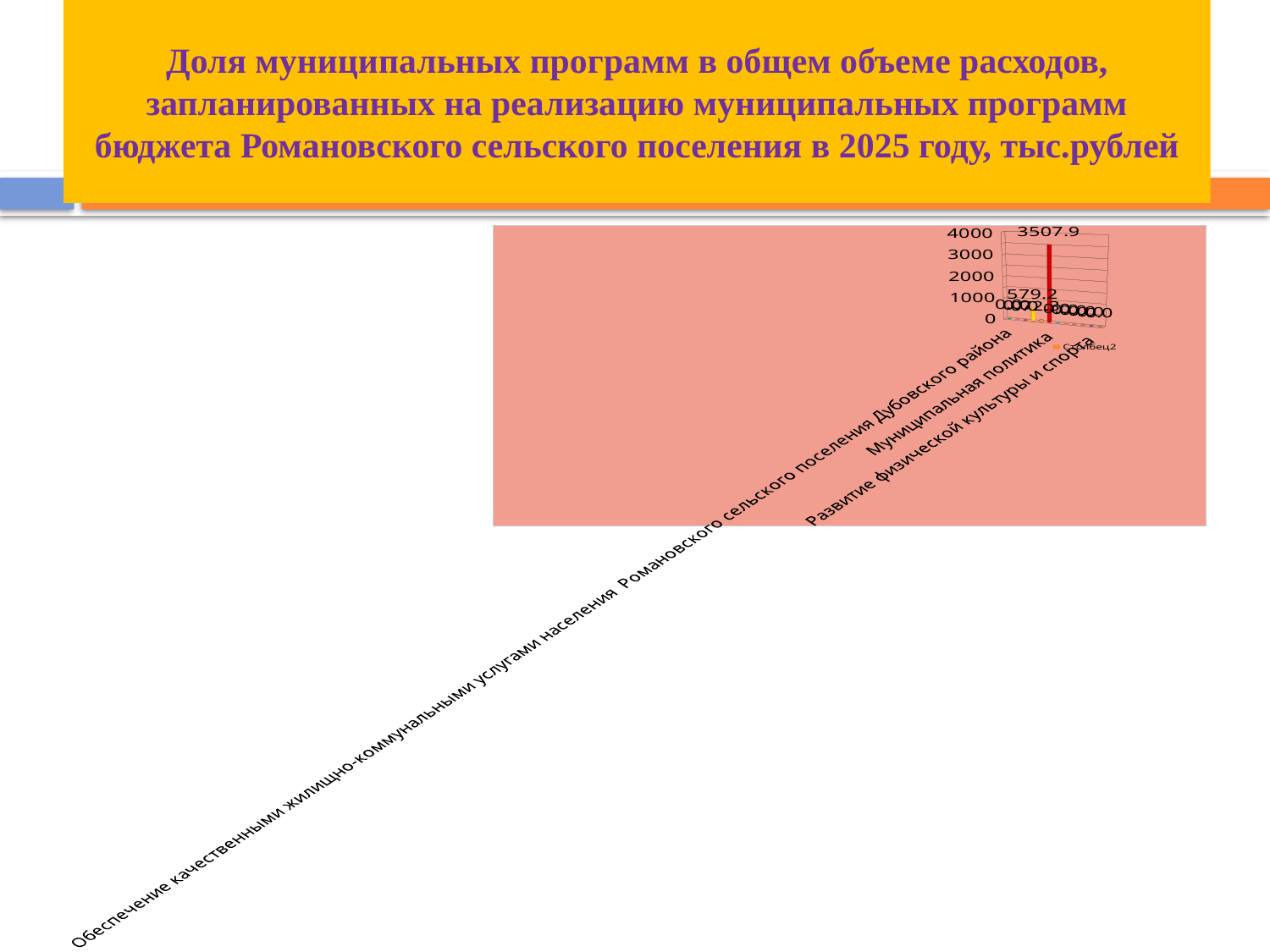
Is the value of the yellow bar greater or less than 1000? less Is the value of the tallest bar greater or less than 3000? greater What kind of chart is shown on the slide? bar chart What is the name of the series shown in the legend? Столбец2 What is the largest data label printed on the chart? 3507.9 What is the highest tick value shown on the vertical axis? 4000 What is the difference between the two non-zero labelled values, 3507.9 and 579.2? 2928.7 How many series does the legend list? 1 Which labelled value is larger, 3507.9 or 579.2? 3507.9